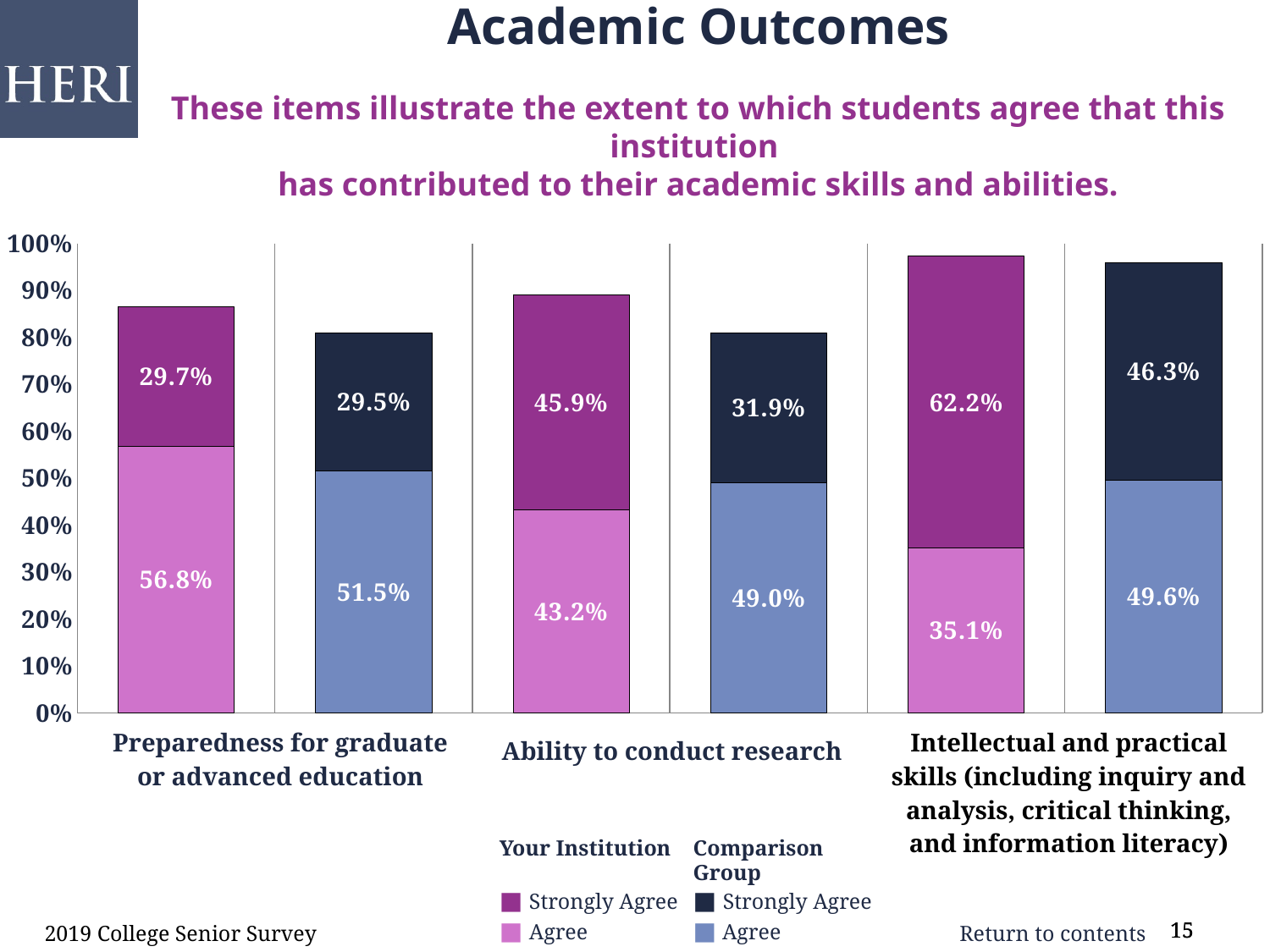
For Ability to conduct research, which is larger: the Your Institution Agree value or the Comparison Group Agree value? Comparison Group Agree (49.0%) Which item has the lowest Comparison Group Strongly Agree value? Preparedness for graduate or advanced education What is the combined Agree plus Strongly Agree total for Your Institution on Preparedness for graduate or advanced education? 86.5% What is the combined Agree plus Strongly Agree total for the Comparison Group on Intellectual and practical skills? 95.9% Across the three items, which has the highest Strongly Agree value for Your Institution? Intellectual and practical skills (including inquiry and analysis, critical thinking, and information literacy) What is the Your Institution Agree value for Preparedness for graduate or advanced education? 56.8% How many entries does the chart legend list? 4 What is the difference between the Your Institution and Comparison Group Strongly Agree values for Intellectual and practical skills? 15.9% How many items (categories) are shown on the x axis of the chart? 3 What percentage of students at Your Institution strongly agree that the institution contributed to their ability to conduct research? 45.9% What is the Comparison Group's Agree value for Intellectual and practical skills? 49.6% What type of chart is shown on the slide? Stacked bar chart